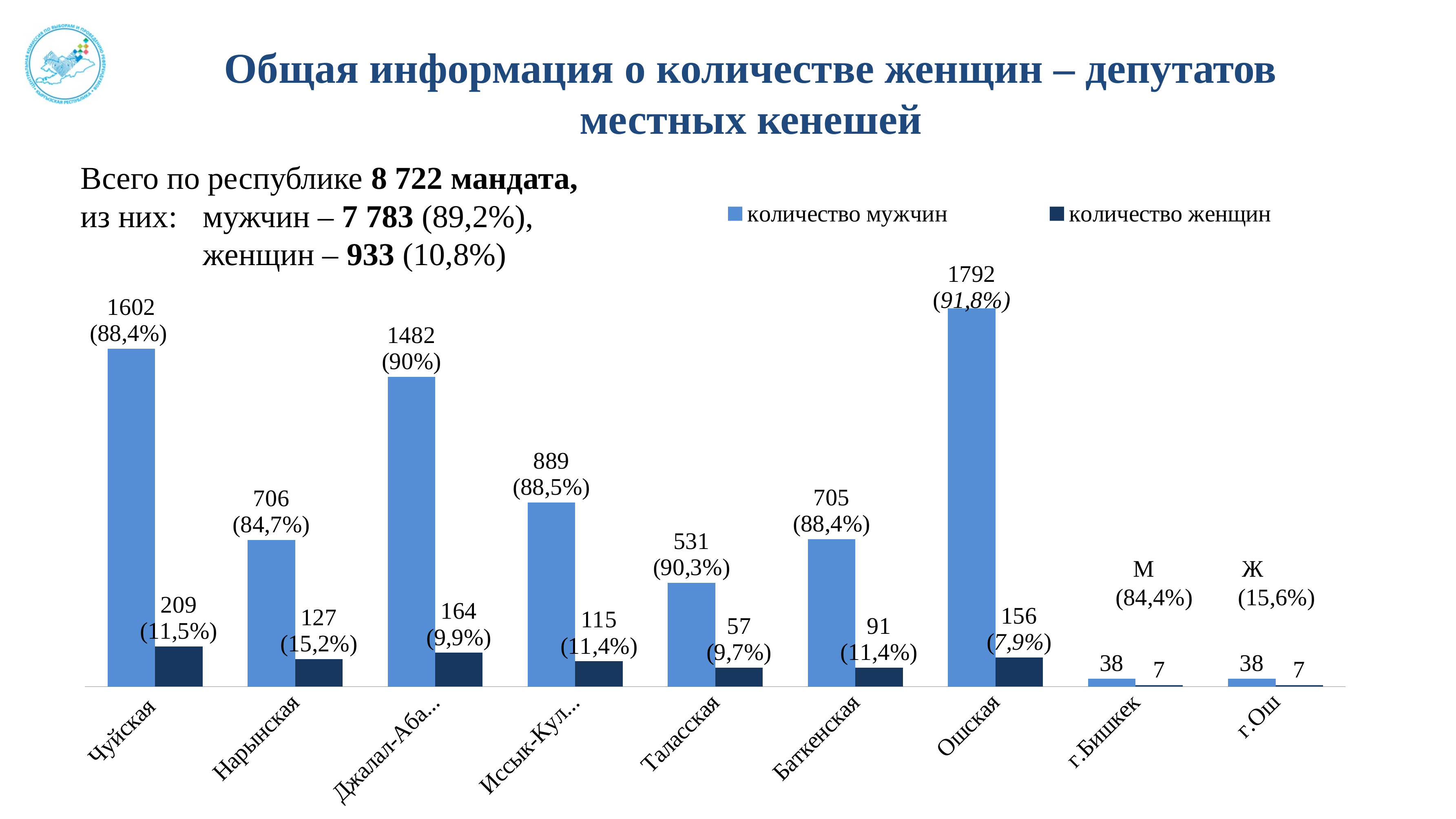
What percentage is shown for women in Ошская? 7,9% What is the difference between the number of men and the number of women in Ошская? 1636 Which category has the highest number of women? Чуйская What kind of chart is shown on the slide? bar chart What are the two legend entries of the chart? количество мужчин, количество женщин What is the total number of men and women combined for Чуйская? 1811 How many series does the legend list? 2 Which has more women: Таласская or Баткенская? Баткенская How many categories are shown on the x axis of the chart? 9 What is the number of women (количество женщин) for Нарынская? 127 Which category has the highest number of men? Ошская What is the number of men (количество мужчин) for Чуйская? 1602